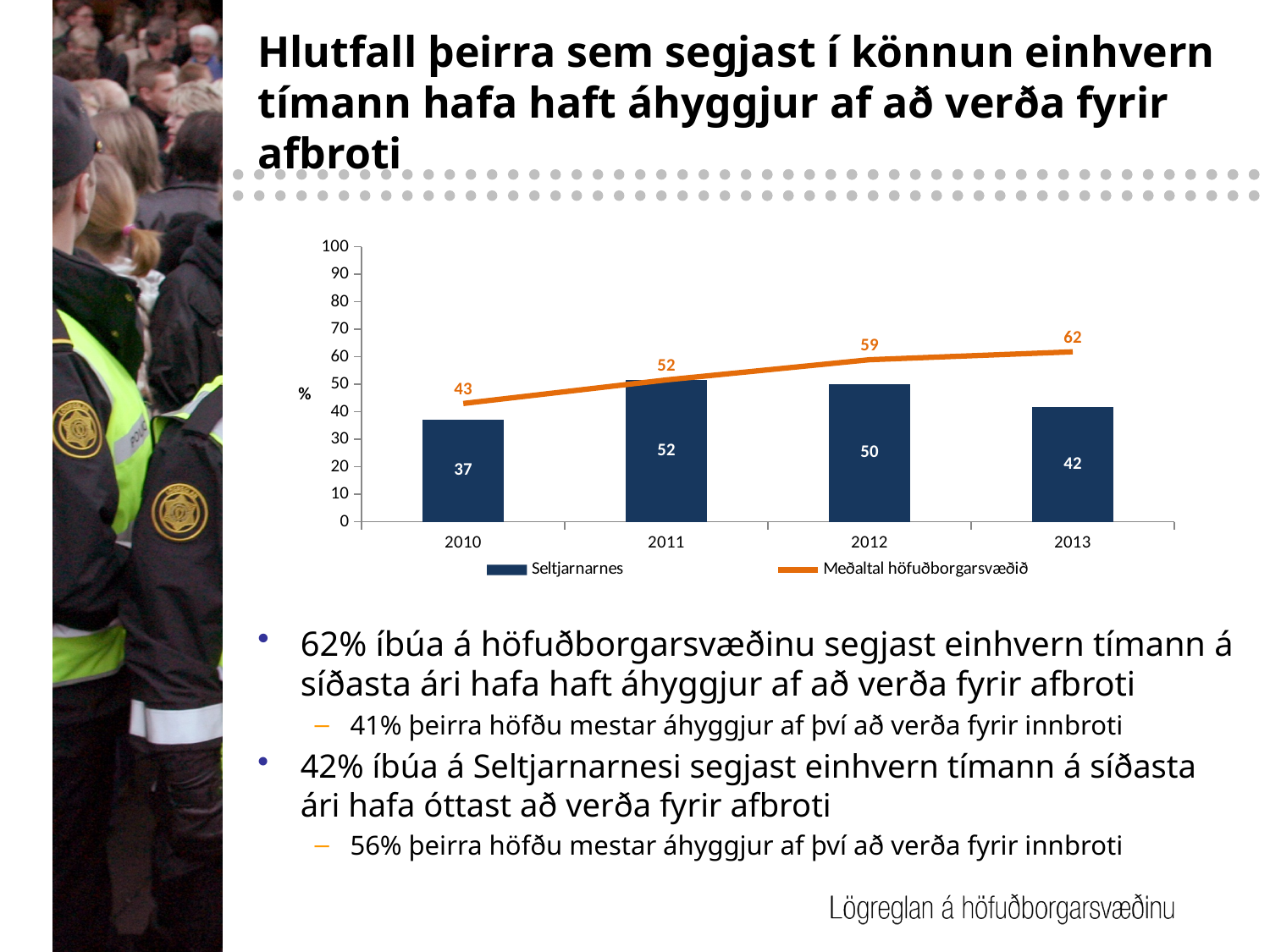
Which is larger in 2012: the Seltjarnarnes value or the Meðaltal höfuðborgarsvæðið value? Meðaltal höfuðborgarsvæðið How many years are shown on the x axis? 4 What is the value for Seltjarnarnes in 2010? 37 Does the Meðaltal höfuðborgarsvæðið line rise or fall from 2010 to 2013? rise What is the value for Meðaltal höfuðborgarsvæðið in 2013? 62 What colour is the Meðaltal höfuðborgarsvæðið line? orange In which year is the Seltjarnarnes value lowest? 2010 What is the difference between the Meðaltal höfuðborgarsvæðið value and the Seltjarnarnes value in 2013? 20 How many series does the legend list? 2 In which year is the Seltjarnarnes value highest? 2011 Is the Seltjarnarnes value for 2011 greater or less than 40? greater What is the value for Seltjarnarnes in 2012? 50